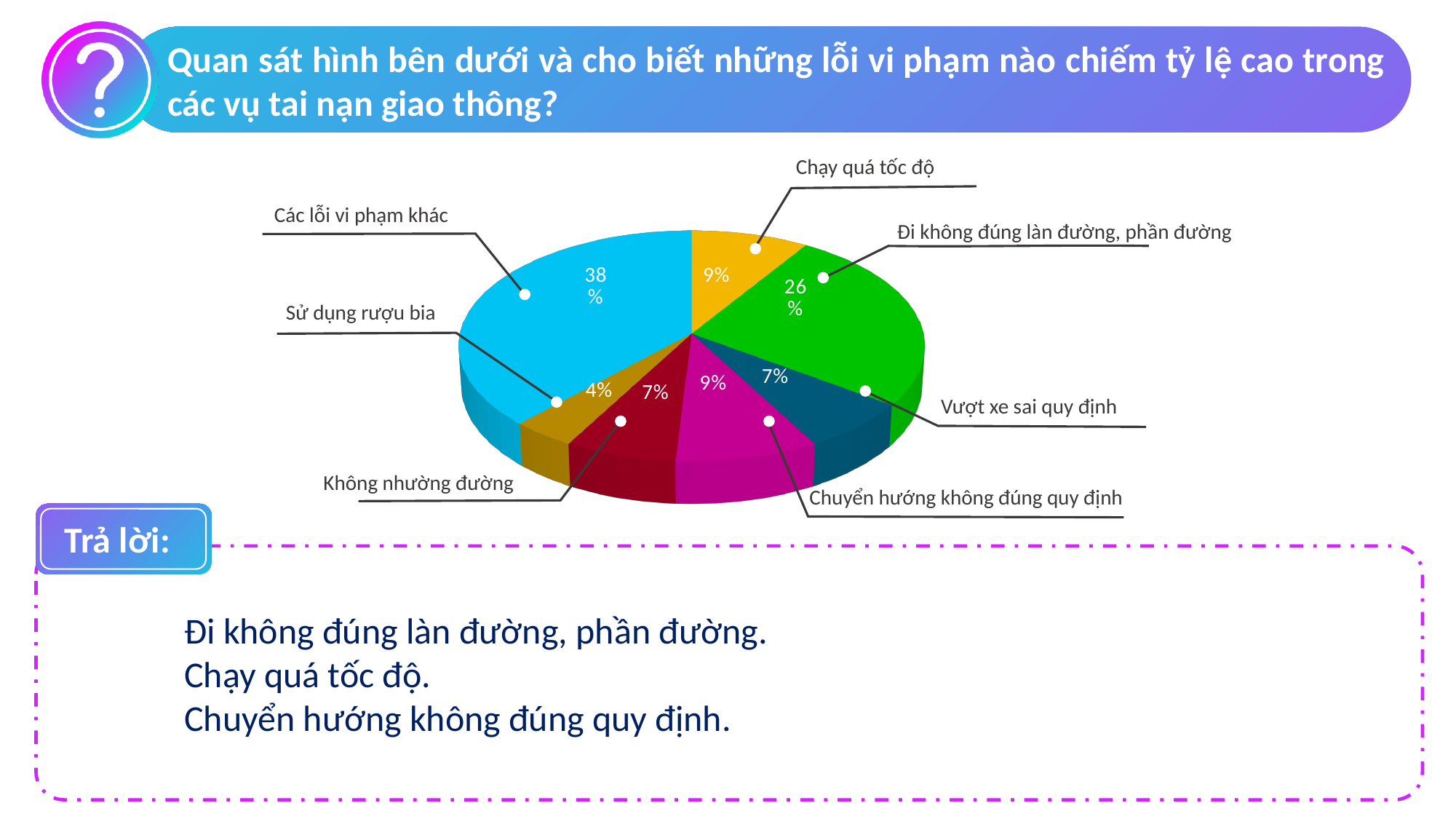
How many slices does the pie chart have? 7 Which category has the largest slice of the pie? Các lỗi vi phạm khác What share of the pie does "Các lỗi vi phạm khác" represent? 38% Which is larger: the share for "Chuyển hướng không đúng quy định" or the share for "Không nhường đường"? Chuyển hướng không đúng quy định What type of chart is shown on the slide? Pie chart What is the difference in percentage points between "Các lỗi vi phạm khác" and "Đi không đúng làn đường, phần đường"? 12 What percentage is shown for "Sử dụng rượu bia"? 4% What percentage is shown for "Vượt xe sai quy định"? 7% What percentage is shown for "Chạy quá tốc độ"? 9% What percentage is shown for "Đi không đúng làn đường, phần đường"? 26% Which category has the smallest slice of the pie? Sử dụng rượu bia What colour is the slice for "Đi không đúng làn đường, phần đường"? Green